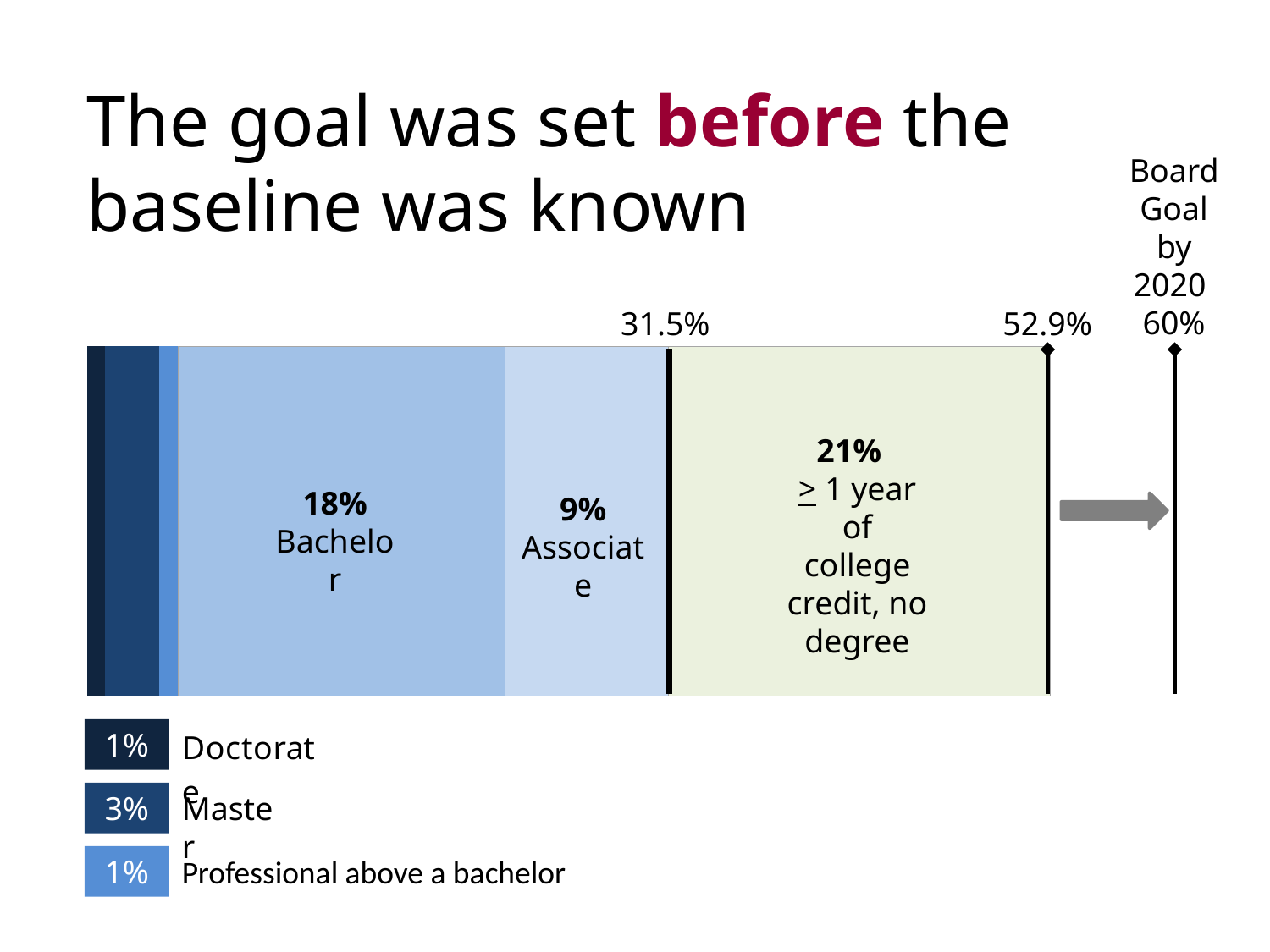
What kind of chart is shown on the slide? Stacked bar chart What is the combined percentage of the Bachelor and Associate segments? 27% What value is marked at the right end of the shaded bar, before the Board Goal marker? 52.9% What percentage is shown for Master in the legend? 3% What percentage is shown for the Bachelor segment? 18% Which segment of the bar has the largest percentage? ≥ 1 year of college credit, no degree What percentage is shown for the segment labelled '≥ 1 year of college credit, no degree'? 21% What percentage is shown for Doctorate in the legend? 1% What percentage is shown for the Associate segment? 9% Which is larger, the Bachelor segment or the Associate segment? Bachelor What is the difference between the Bachelor percentage and the Associate percentage? 9% What is the Board Goal by 2020 shown on the slide? 60%